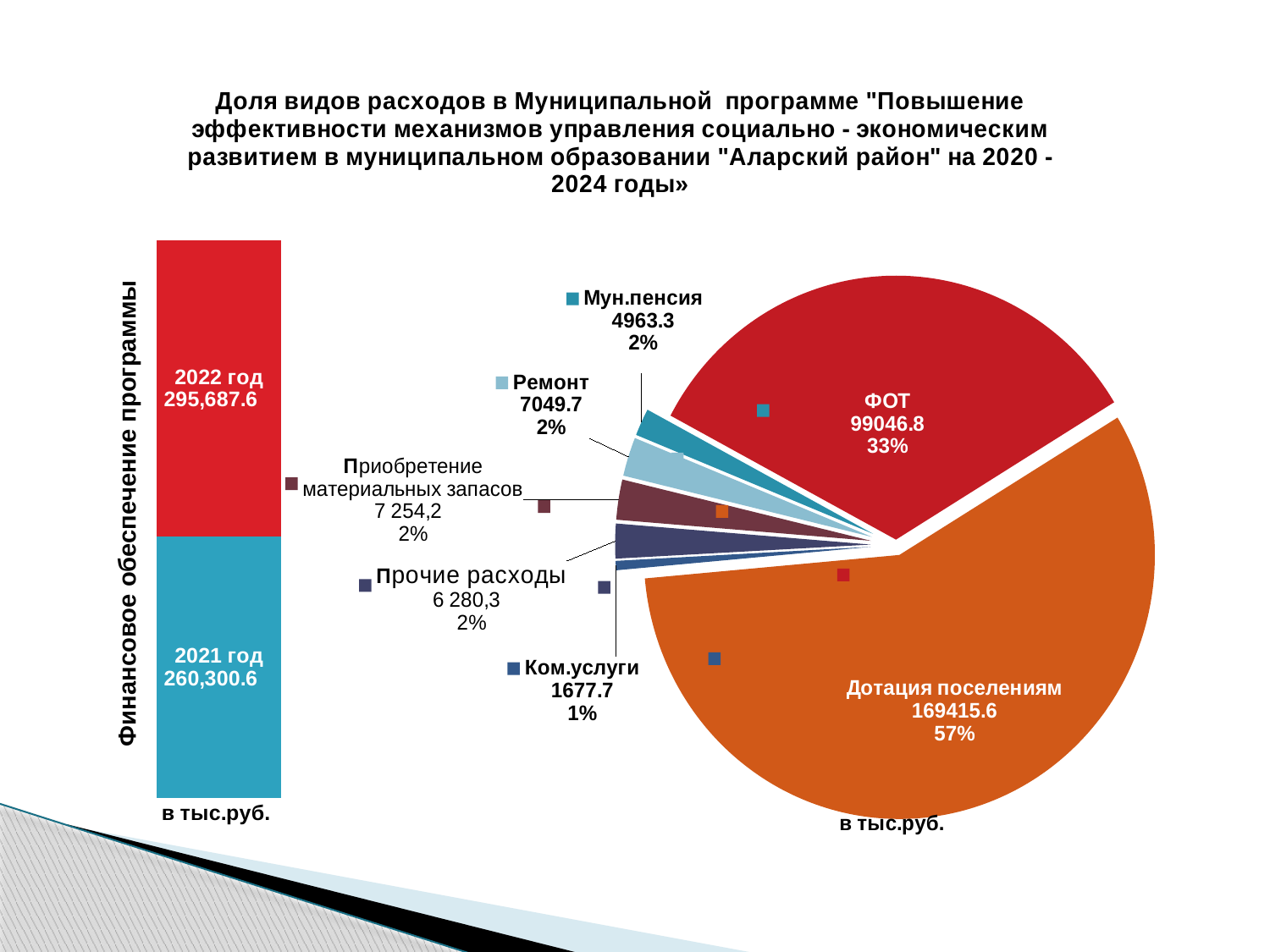
In the stacked bar chart on the left, what is the total of the two segments? 555,988.2 In the pie chart on the right, what is the value for ФОТ? 99046.8 In the pie chart on the right, which slice is the smallest? Ком.услуги How many slices does the pie chart on the right have? 7 In the pie chart on the right, which slice is the largest? Дотация поселениям In the pie chart on the right, what share does Дотация поселениям have? 57% In the stacked bar chart on the left, what is the value for 2021 год? 260,300.6 In the stacked bar chart on the left, what is the value for 2022 год? 295,687.6 In the stacked bar chart on the left, which year has the larger value, 2021 год or 2022 год? 2022 год What kind of chart is on the left of the slide? bar chart In the pie chart on the right, what is the difference between Дотация поселениям and ФОТ? 70368.8 What kind of chart is on the right of the slide? pie chart